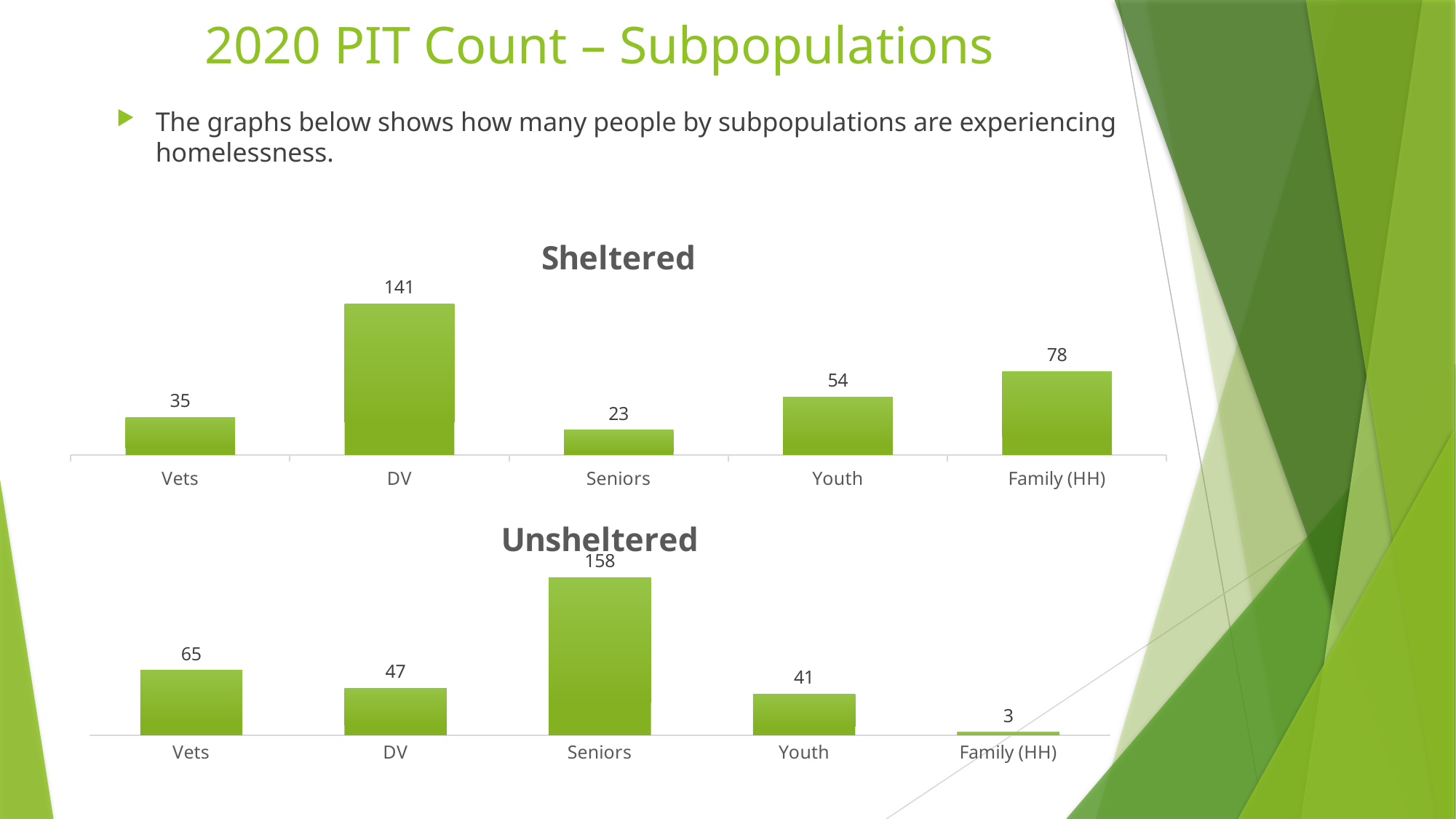
In the Unsheltered chart, what is the value for Vets? 65 In the Sheltered chart, which category has the highest value? DV In the Unsheltered chart, what is the value for Family (HH)? 3 In the Sheltered chart, what is the value for DV? 141 How many categories are shown in the Unsheltered chart? 5 In the Unsheltered chart, which category has the highest value? Seniors In the Unsheltered chart, what is the difference between the values for Seniors and DV? 111 In the Sheltered chart, what is the value for Seniors? 23 In the Unsheltered chart, which category has the lowest value? Family (HH) In the Sheltered chart, what is the difference between the values for Family (HH) and Youth? 24 What kind of chart is the Sheltered chart? Bar chart In the Sheltered chart, which is larger, the value for Vets or the value for Seniors? Vets